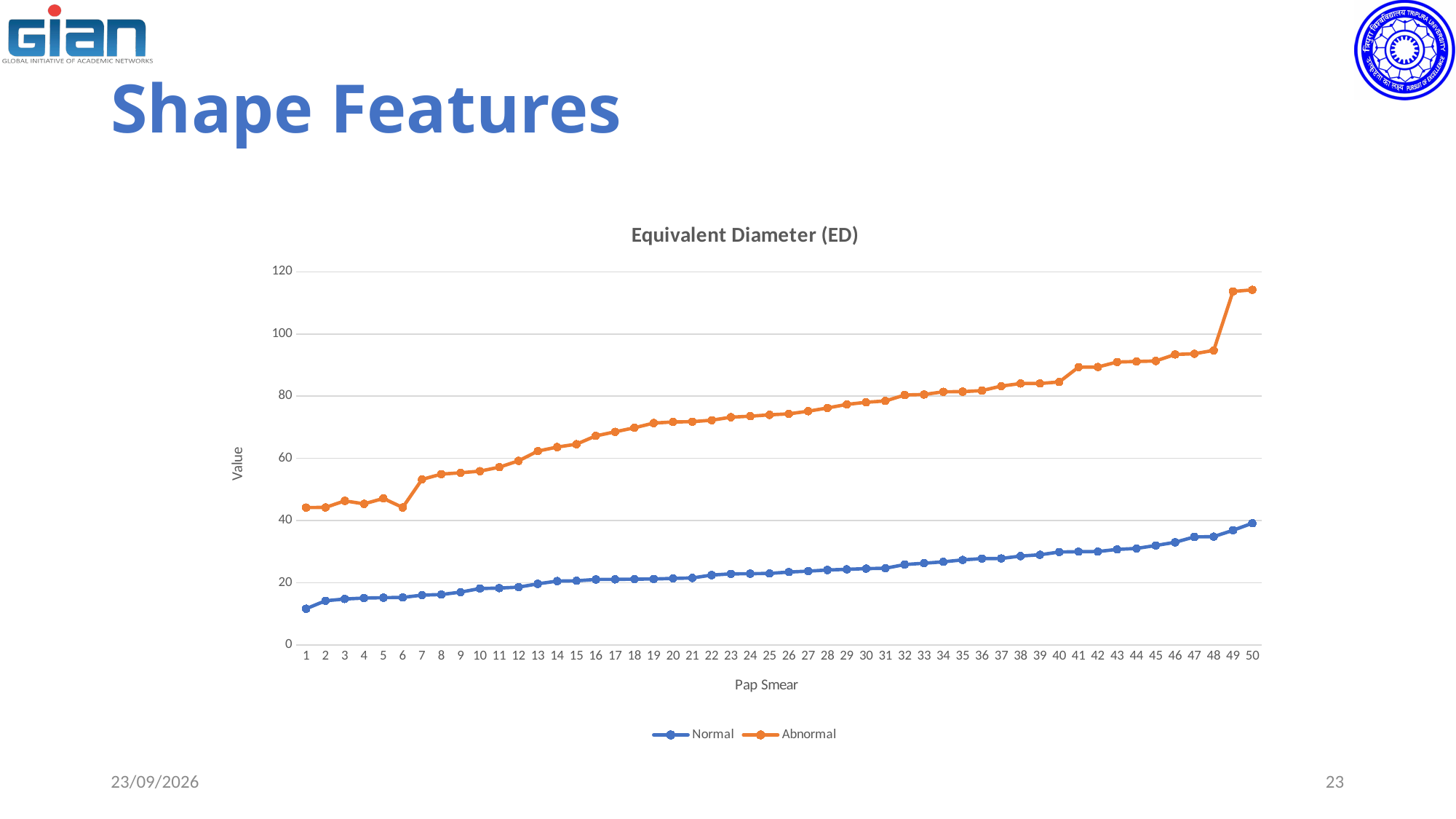
How many Pap Smear points are plotted along the x axis? 50 What is the title of the chart? Equivalent Diameter (ED) Is the Abnormal value at Pap Smear 50 greater or less than 100? greater What kind of chart is shown on the slide? line chart At which Pap Smear number is the Normal series lowest? 1 What is the label of the x axis? Pap Smear Which series has the larger value at Pap Smear 50, Normal or Abnormal? Abnormal How many series does the legend list? 2 Is the Abnormal value at Pap Smear 1 greater or less than 40? greater Do the Abnormal values rise or fall along the x axis? rise Is the Normal value at Pap Smear 1 greater or less than 20? less